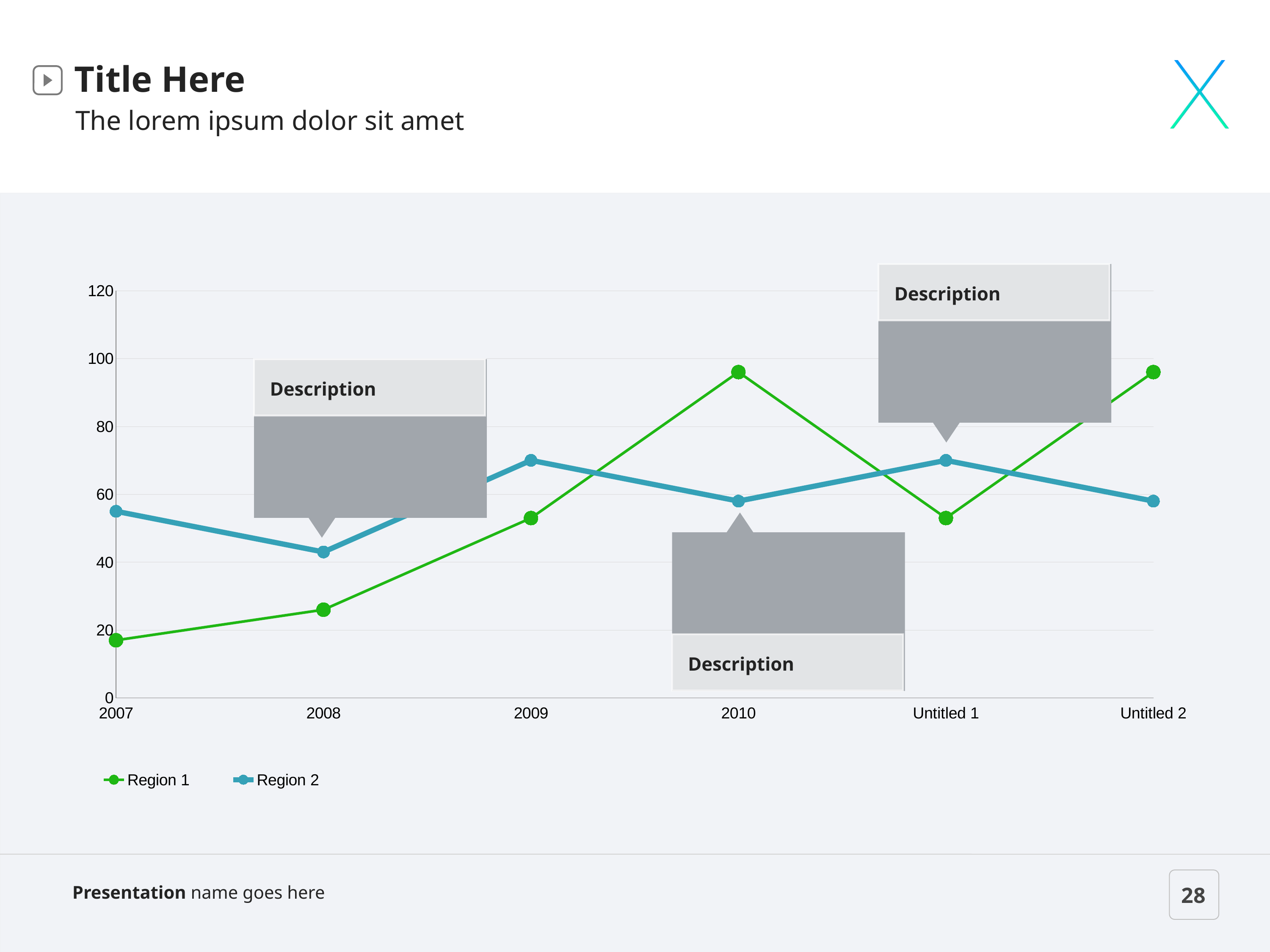
Is the value for Region 1 in 2009 greater or less than 60? less How many series does the legend list? 2 How many categories are shown on the x axis? 6 Which category has the lowest value for Region 2? 2008 Is the value for Region 1 in 2010 greater or less than 80? greater Does the Region 1 line rise or fall from 2007 to 2010? rise Is the value for Region 1 in 2007 greater or less than 20? less What kind of chart is shown on the slide? line chart Which category has the lowest value for Region 1? 2007 In 2010, which series has the larger value, Region 1 or Region 2? Region 1 In 2007, which series has the larger value, Region 1 or Region 2? Region 2